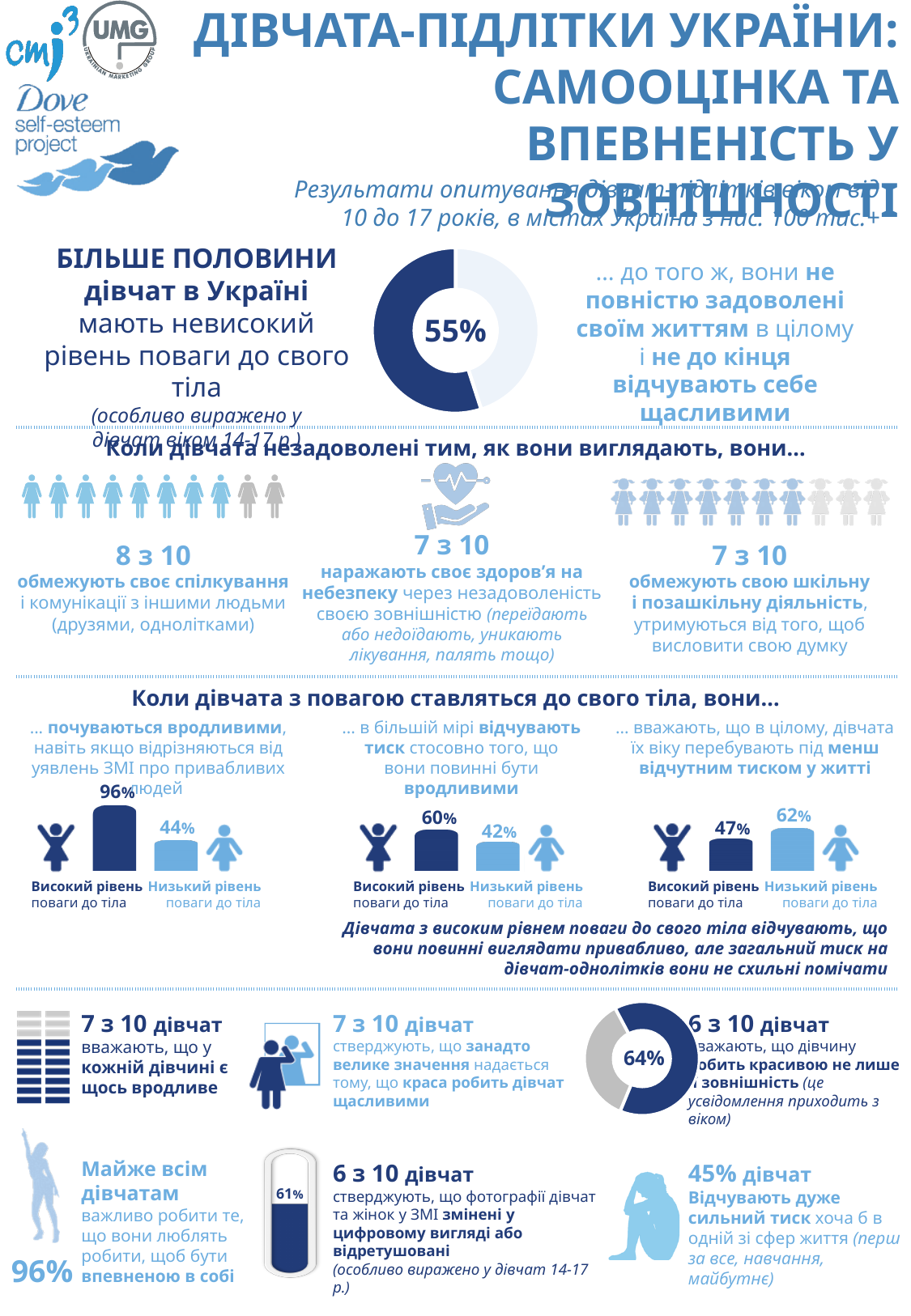
How many bars does each of the three small bar charts in the middle section contain? 2 In the donut chart at the bottom right of the slide, what percentage is shown? 64% In the middle bar chart (under 'відчувають тиск'), what is the value for 'Високий рівень поваги до тіла'? 60% In the left bar chart (under 'почуваються вродливими'), what is the difference between the high and low body-esteem values? 52% In the donut chart at the top of the slide, what percentage is shown in the centre? 55% In the left bar chart (under 'почуваються вродливими'), what is the value for 'Низький рівень поваги до тіла'? 44% In the left bar chart (under 'почуваються вродливими'), what is the value for 'Високий рівень поваги до тіла'? 96% In the right bar chart (under 'менш відчутним тиском у житті'), which group has the larger value? Низький рівень поваги до тіла What kind of chart is the one at the top of the slide showing 55%? Donut (pie) chart In the right bar chart (under 'менш відчутним тиском у житті'), what is the difference between the two bars? 15% What percentage is shown on the thermometer-style gauge at the bottom of the slide? 61% In the middle bar chart (under 'відчувають тиск'), what is the value for 'Низький рівень поваги до тіла'? 42%